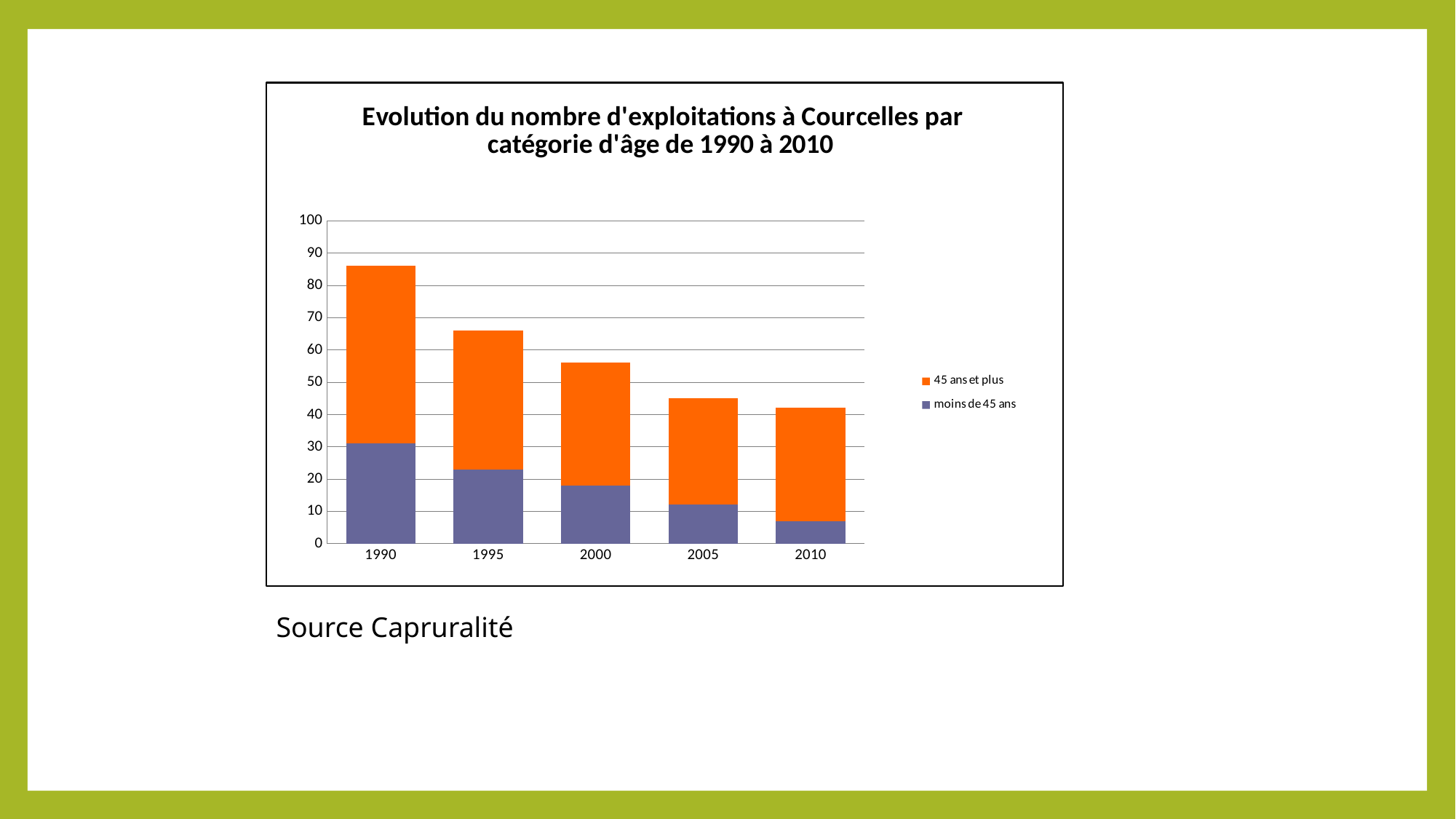
Is the total value for 1990 greater or less than 80? greater Is the value for 'moins de 45 ans' in 2010 greater or less than 10? less Which year has the lowest total number of exploitations? 2010 How many series does the legend list? 2 What is the title of the chart? Evolution du nombre d'exploitations à Courcelles par catégorie d'âge de 1990 à 2010 Which series is shown in orange in the legend? 45 ans et plus What kind of chart is shown on the slide? bar chart Is the total value for 2010 greater or less than 50? less How many years are shown on the x axis of the chart? 5 Which year has a larger total bar, 1990 or 1995? 1990 Which year has the highest total number of exploitations? 1990 Does the total number of exploitations rise or fall from 1990 to 2010? fall